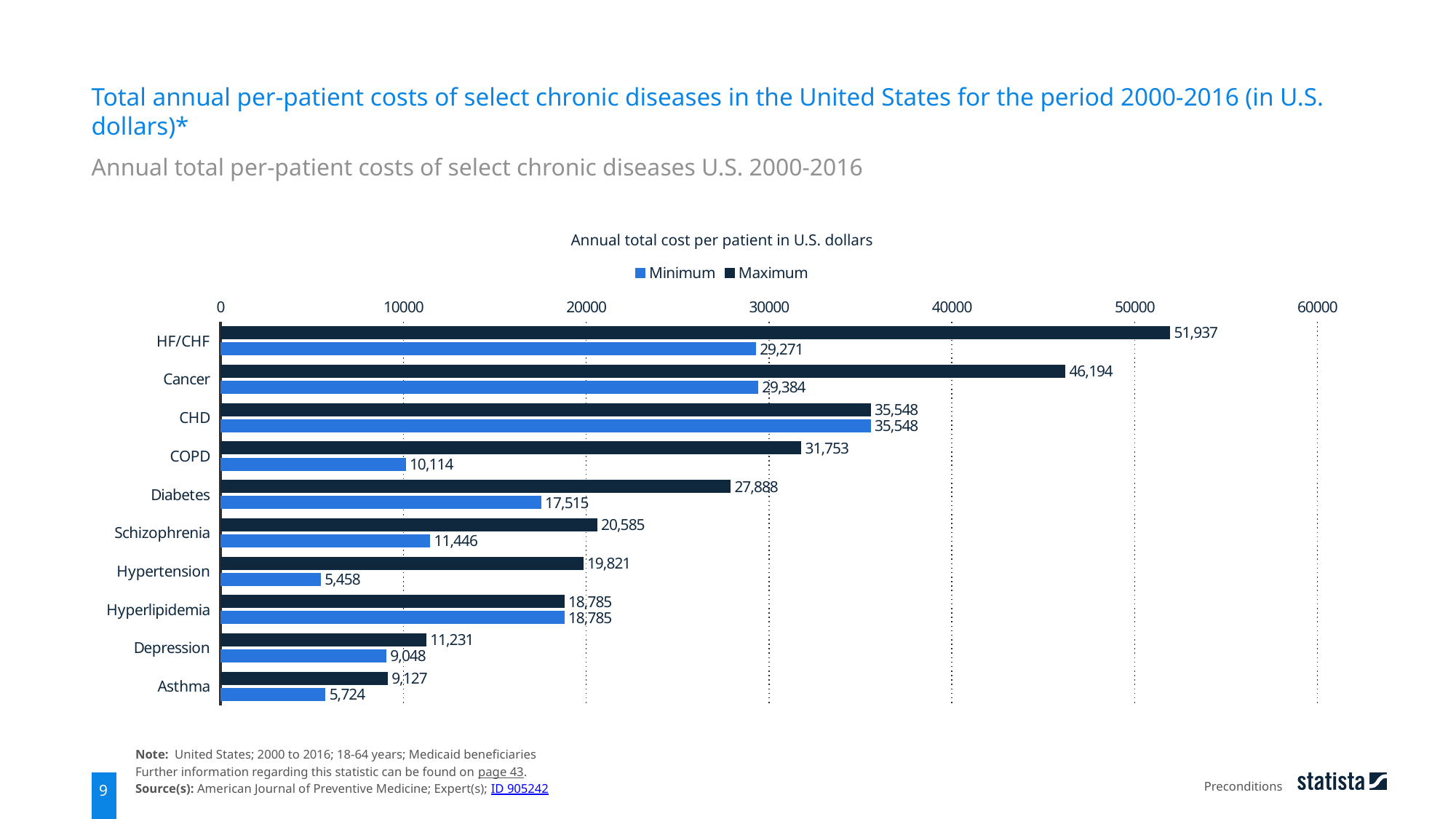
Which series is shown in dark navy in the legend? Maximum Which disease has the highest Maximum annual total cost per patient? HF/CHF What is the Minimum annual total cost per patient for Asthma? 5,724 What is the Maximum annual total cost per patient for HF/CHF? 51,937 How many diseases are shown on the chart? 10 What kind of chart is shown on the slide? bar chart What is the difference between the Maximum and Minimum cost per patient for COPD? 21,639 Is the Minimum cost per patient for Diabetes greater or less than 20000? less What is the Minimum annual total cost per patient for Hypertension? 5,458 Which is larger: the Maximum cost for Cancer or the Maximum cost for CHD? Cancer Which disease has the lowest Minimum annual total cost per patient? Hypertension How many series does the legend list? 2